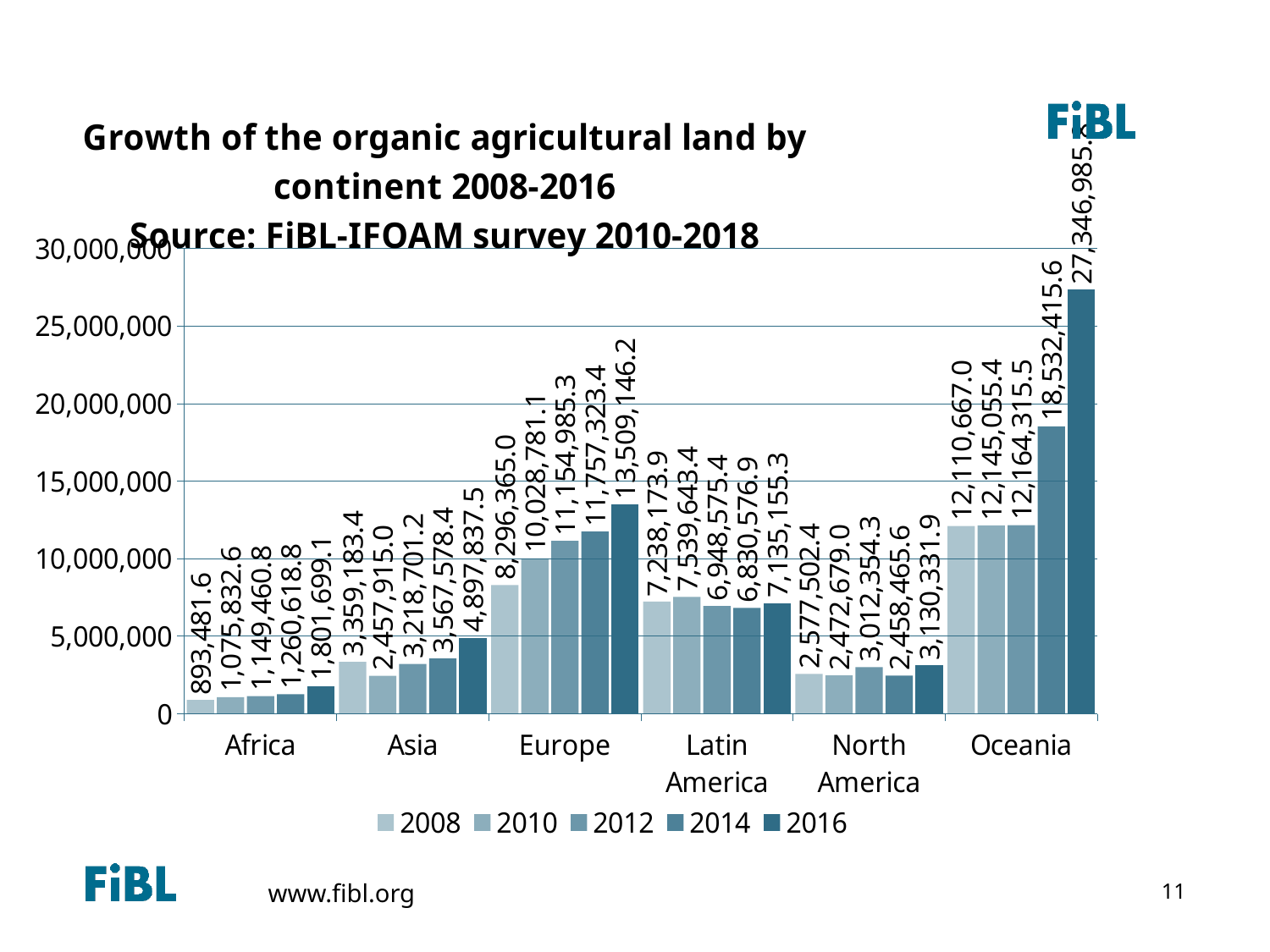
Which continent has the lowest value in 2008? Africa Is the value for Oceania in 2016 greater or less than 25,000,000? greater What is the value for Europe in 2016? 13,509,146.2 What kind of chart is shown on the slide? bar chart What is the value for Africa in 2008? 893,481.6 What is the value for Oceania in 2014? 18,532,415.6 What is the difference between the Europe values for 2016 and 2008? 5,212,781.2 What is the value for North America in 2012? 3,012,354.3 Which is larger for Latin America: the 2008 value or the 2016 value? 2008 How many series does the legend list? 5 How many continents are shown on the x axis? 6 Which continent has the highest value in 2016? Oceania